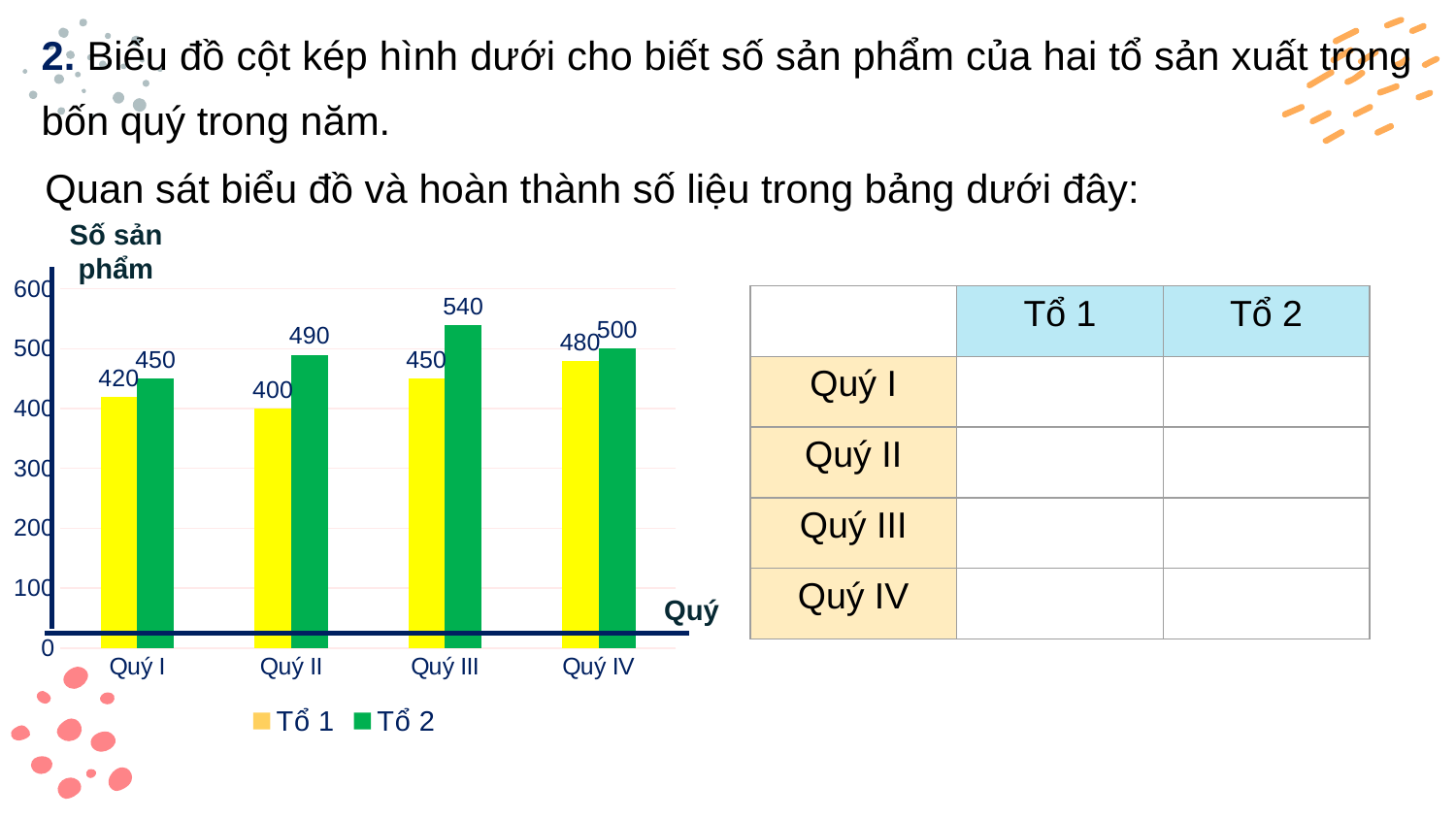
What is the value for Tổ 2 in Quý II? 490 What kind of chart is shown? Bar chart What is the value for Tổ 1 in Quý IV? 480 What is the difference between Tổ 2 and Tổ 1 in Quý II? 90 What is the value for Tổ 1 in Quý I? 420 What is the value for Tổ 2 in Quý III? 540 In which quarter is the value for Tổ 2 highest? Quý III In which quarter is the value for Tổ 1 lowest? Quý II How many series does the legend list? 2 Do the values for Tổ 2 rise or fall from Quý I to Quý III? Rise How many quarters are shown on the x axis? 4 Which is larger in Quý IV, Tổ 1 or Tổ 2? Tổ 2